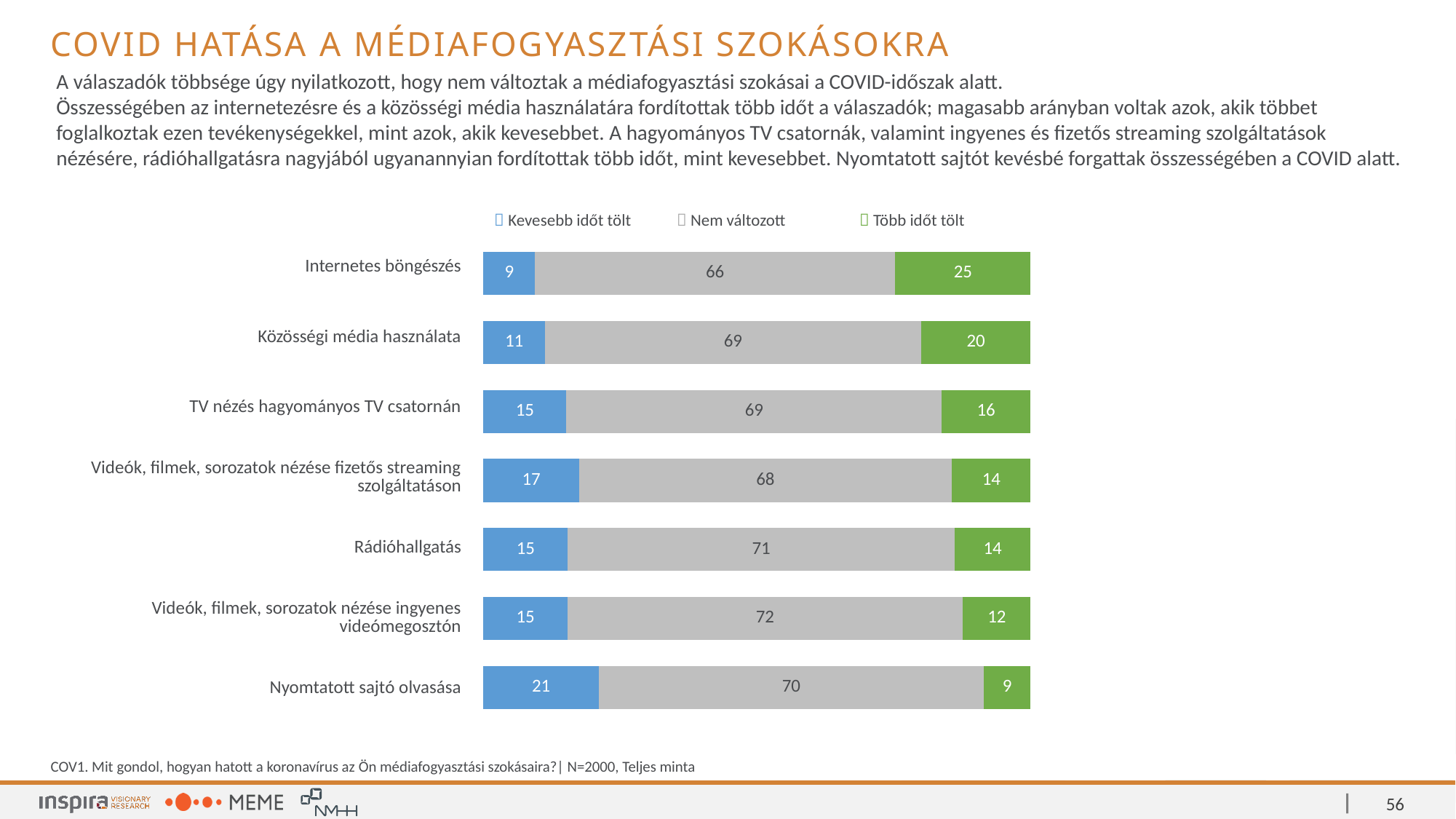
Which is larger: the "Kevesebb időt tölt" value for Nyomtatott sajtó olvasása or for Videók, filmek, sorozatok nézése fizetős streaming szolgáltatáson? Nyomtatott sajtó olvasása How many series does the legend list? 3 What kind of chart is shown on the slide? Stacked bar chart Which legend entry is shown in green? Több időt tölt What is the "Több időt tölt" value for Internetes böngészés? 25 What is the total of the stacked bar for Közösségi média használata? 100 What is the "Nem változott" value for Rádióhallgatás? 71 Which category has the lowest "Kevesebb időt tölt" value? Internetes böngészés What is the difference between the "Több időt tölt" values for Internetes böngészés and Közösségi média használata? 5 What is the "Kevesebb időt tölt" value for Nyomtatott sajtó olvasása? 21 How many categories are shown in the chart? 7 Which category has the highest "Több időt tölt" value? Internetes böngészés